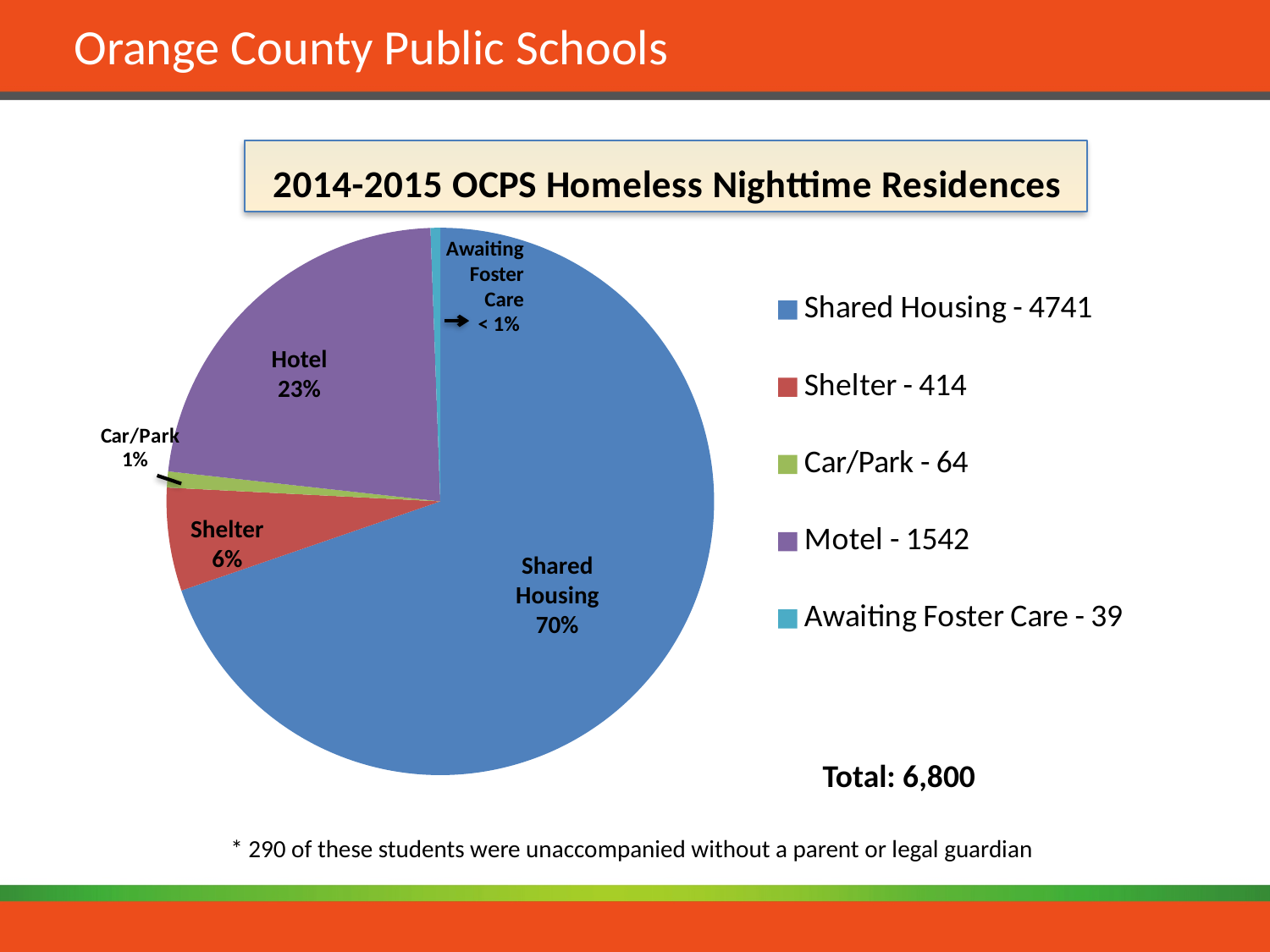
What share of the pie does the Shelter slice represent? 6% How many slices does the pie chart have? 5 What count is given for Shared Housing in the legend? 4741 What share of the pie does Shared Housing represent? 70% What count is given for Awaiting Foster Care in the legend? 39 Which category has the smallest slice of the pie? Awaiting Foster Care What percentage is shown for the Hotel slice? 23% What is the difference between the Motel count and the Shelter count shown in the legend? 1128 Which category has the largest slice of the pie? Shared Housing What is the title of the pie chart? 2014-2015 OCPS Homeless Nighttime Residences How many entries does the legend list? 5 What kind of chart is shown on the slide? pie chart